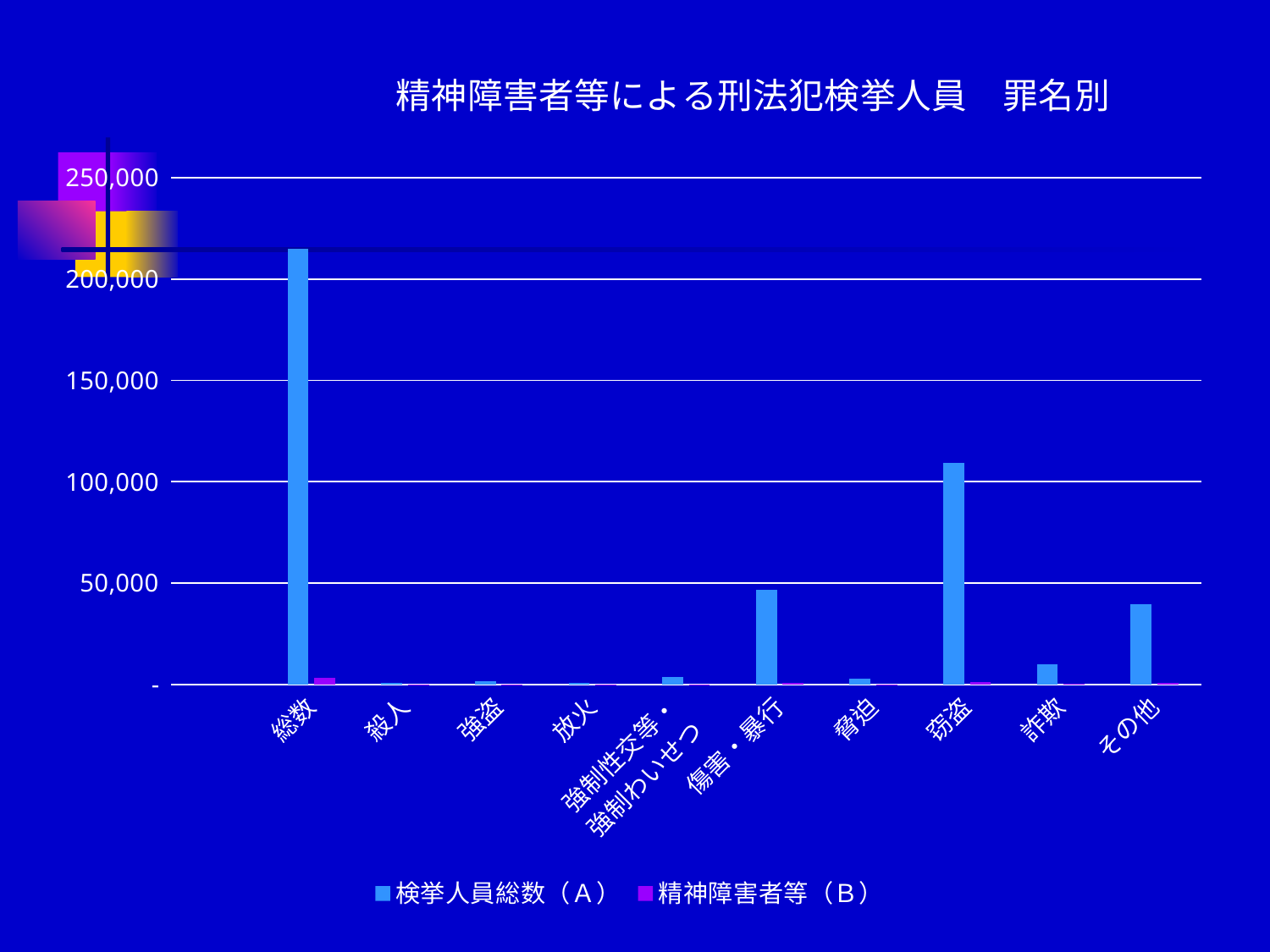
Is the value of 検挙人員総数（A） for 傷害・暴行 greater or less than 50,000? less Excluding 総数, which crime category has the highest value for 検挙人員総数（A）? 窃盗 What kind of chart is shown on the slide? bar chart What is the title of the chart? 精神障害者等による刑法犯検挙人員 罪名別 Is the value of 検挙人員総数（A） for 総数 greater or less than 200,000? greater Which series is shown in purple in the legend? 精神障害者等（B） How many categories are shown on the x axis of the chart? 10 Which has the larger value for 検挙人員総数（A）, その他 or 詐欺? その他 Which category has the highest value for 検挙人員総数（A）? 総数 How many series does the legend list? 2 Is the value of 検挙人員総数（A） for 窃盗 greater or less than 100,000? greater Which has the larger value for 検挙人員総数（A）, 窃盗 or 傷害・暴行? 窃盗